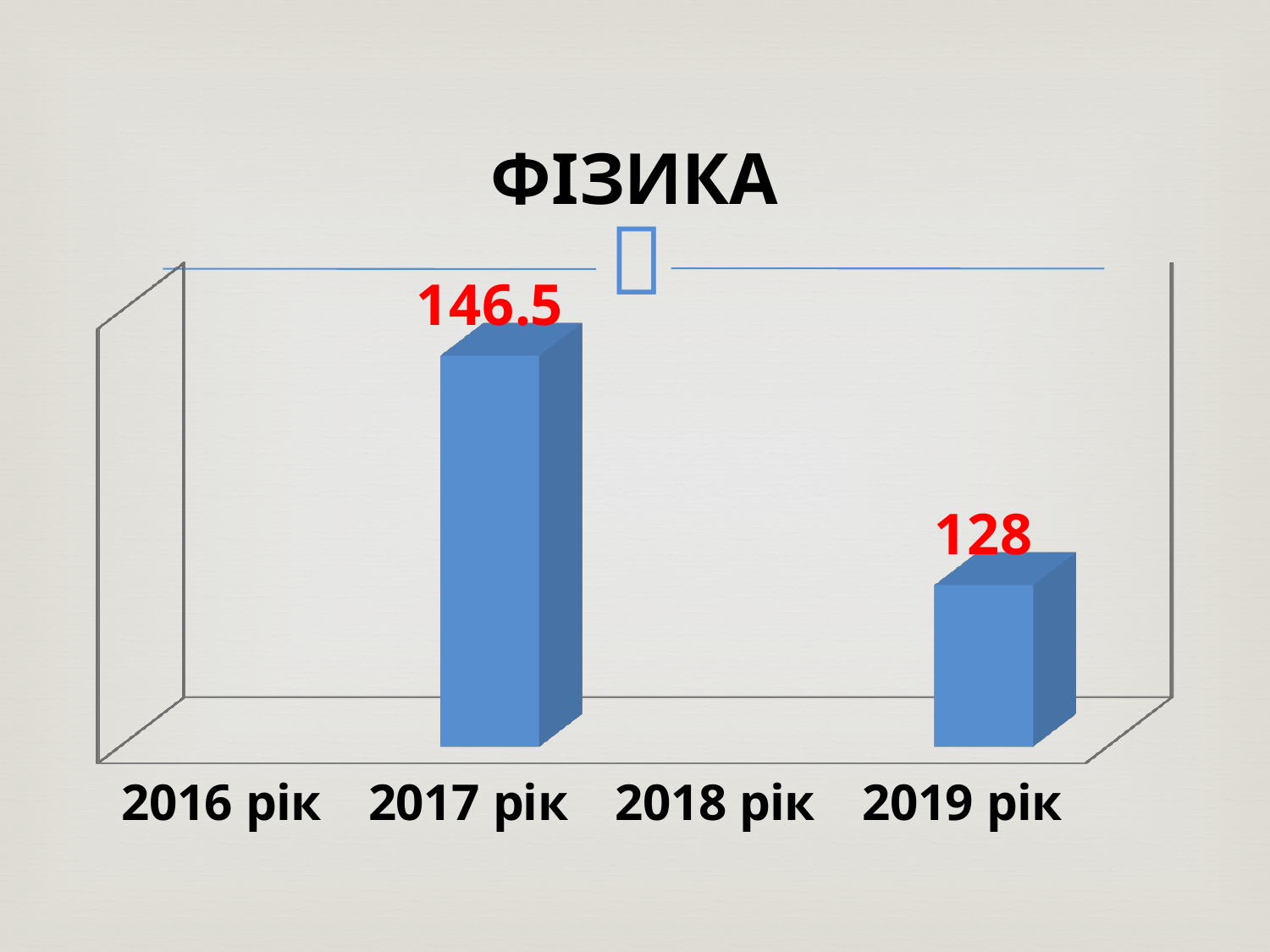
Does the value rise or fall from 2017 рік to 2019 рік? Fall Which year has the highest bar? 2017 рік What colour are the bars in the chart? Blue What is the difference between the values for 2017 рік and 2019 рік? 18.5 What is the value for 2019 рік? 128 What is the title of the chart? ФІЗИКА Which is larger, the value for 2017 рік or the value for 2019 рік? 2017 рік Which of the years with a plotted bar has the lowest value? 2019 рік What kind of chart is shown on the slide? Bar chart How many year categories are labelled on the x axis? 4 How many bars are plotted on the chart? 2 What is the value for 2017 рік? 146.5